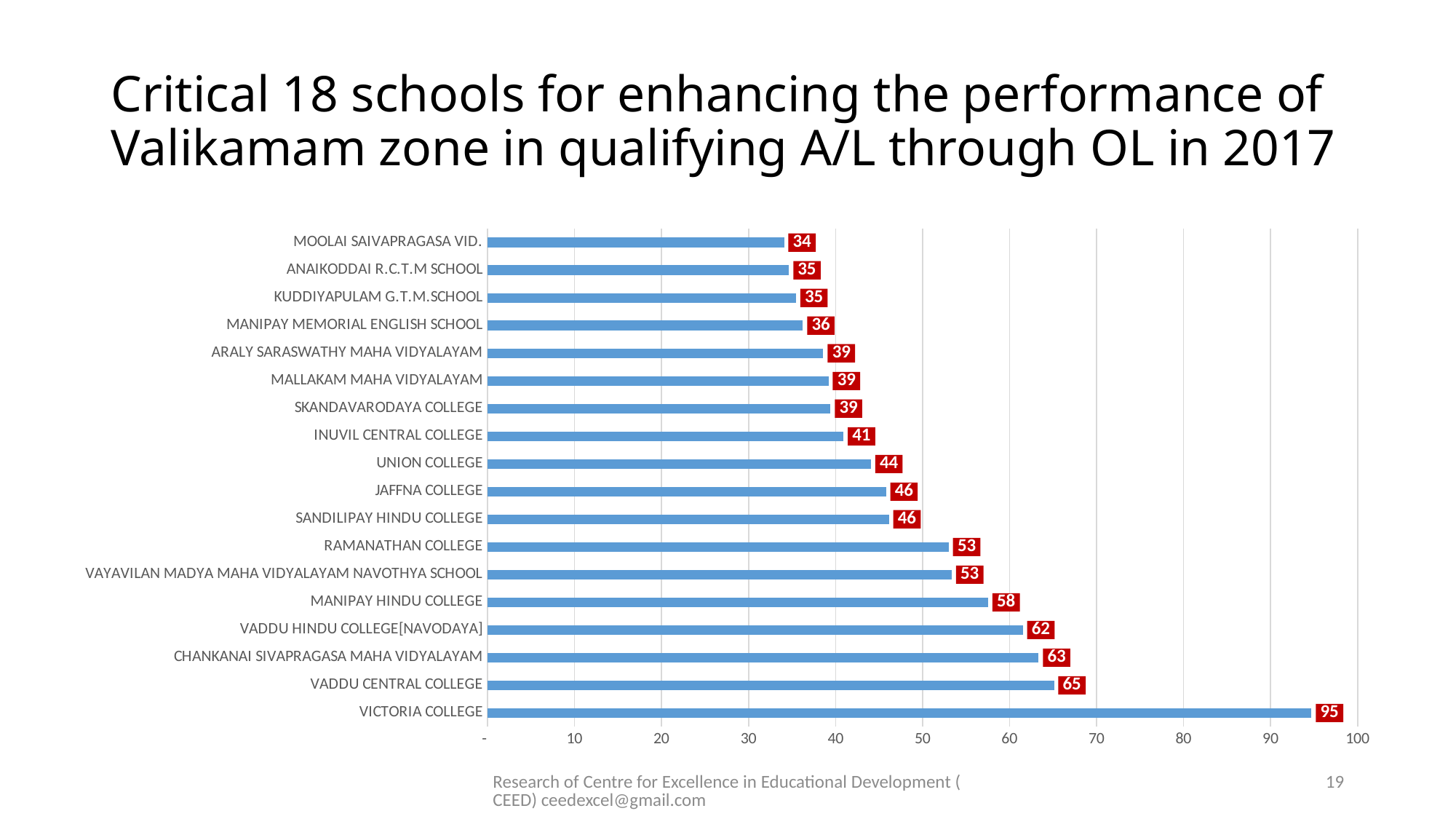
What is the difference between the values for Victoria College and Vaddu Central College? 30 Is the value for Vaddu Hindu College[Navodaya] greater or less than 60? greater What is the value for Victoria College? 95 Which school has the highest value? Victoria College What is the value for Manipay Hindu College? 58 What kind of chart is shown on the slide? Bar chart Which school has the lowest value? Moolai Saivapragasa Vid. How many schools are shown in the chart? 18 What colour are the bars in the chart? Blue Which has a larger value, Union College or Ramanathan College? Ramanathan College What is the difference between the values for Inuvil Central College and Moolai Saivapragasa Vid.? 7 What is the value for Jaffna College? 46